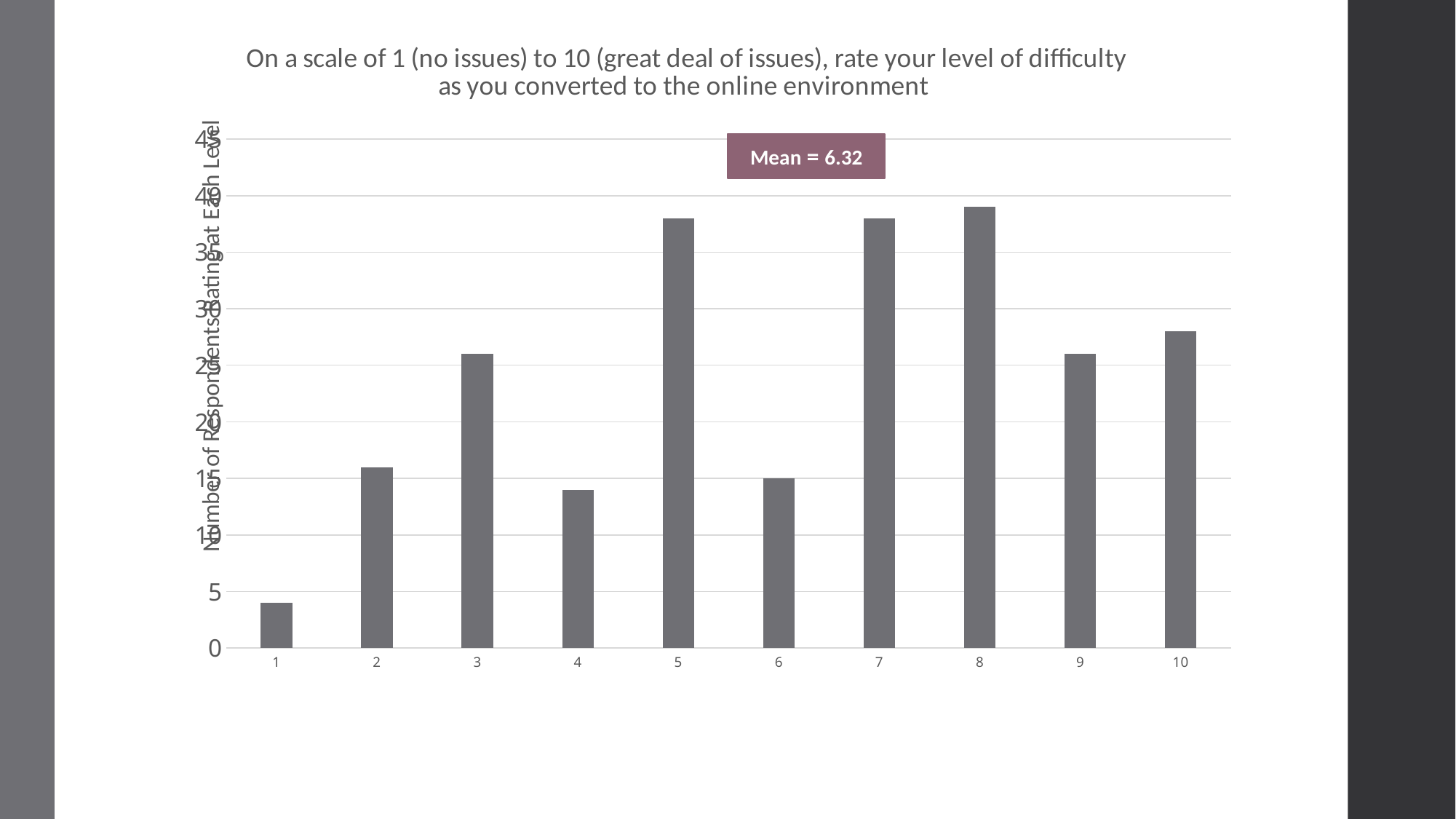
Which rating level has the lowest number of respondents? 1 What mean value is shown in the box on the chart? Mean = 6.32 What kind of chart is shown on the slide? bar chart Is the value for rating level 8 greater or less than 40? less Which has more respondents, rating level 7 or rating level 6? 7 Is the value for rating level 1 greater or less than 5? less Is the value for rating level 3 greater or less than 20? greater Which has more respondents, rating level 5 or rating level 3? 5 How many rating levels (categories) are shown on the x axis? 10